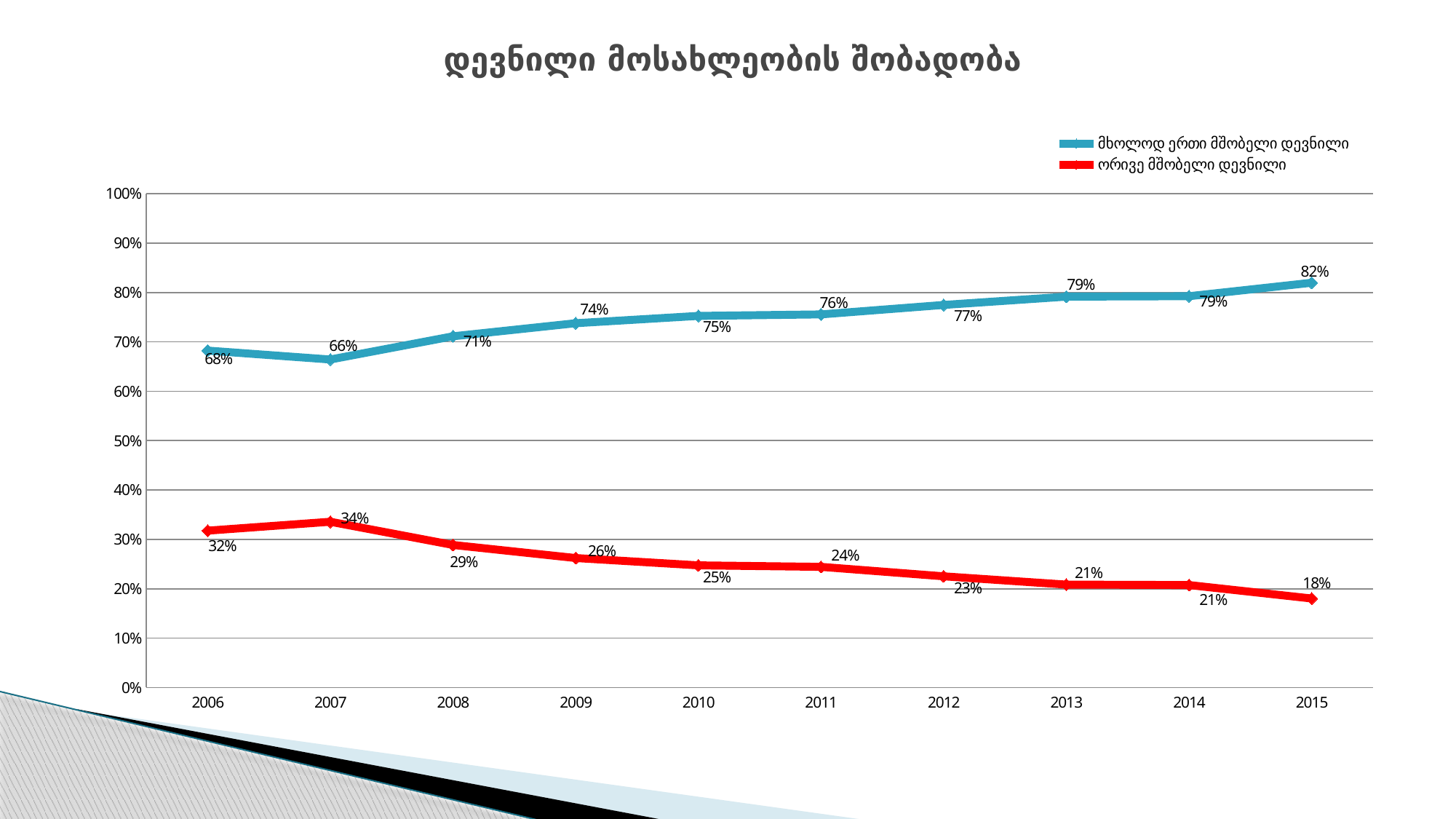
What is the value of the blue series (მხოლოდ ერთი მშობელი დევნილი) in 2015? 82% In which year is the blue series (მხოლოდ ერთი მშობელი დევნილი) lowest? 2007 What is the title of the chart? დევნილი მოსახლეობის შობადობა How many series does the legend list? 2 What type of chart is shown on the slide? line chart In which year is the red series (ორივე მშობელი დევნილი) highest? 2007 What is the value of the red series (ორივე მშობელი დევნილი) in 2008? 29% Does the red series (ორივე მშობელი დევნილი) generally rise or fall from 2007 to 2015? fall Which series has the larger value in 2010, the blue (მხოლოდ ერთი მშობელი დევნილი) or the red (ორივე მშობელი დევნილი)? blue (მხოლოდ ერთი მშობელი დევნილი) Is the value of the blue series in 2009 greater or less than 70%? greater How many years are shown on the x axis? 10 What is the difference between the blue and red series values in 2006? 36%